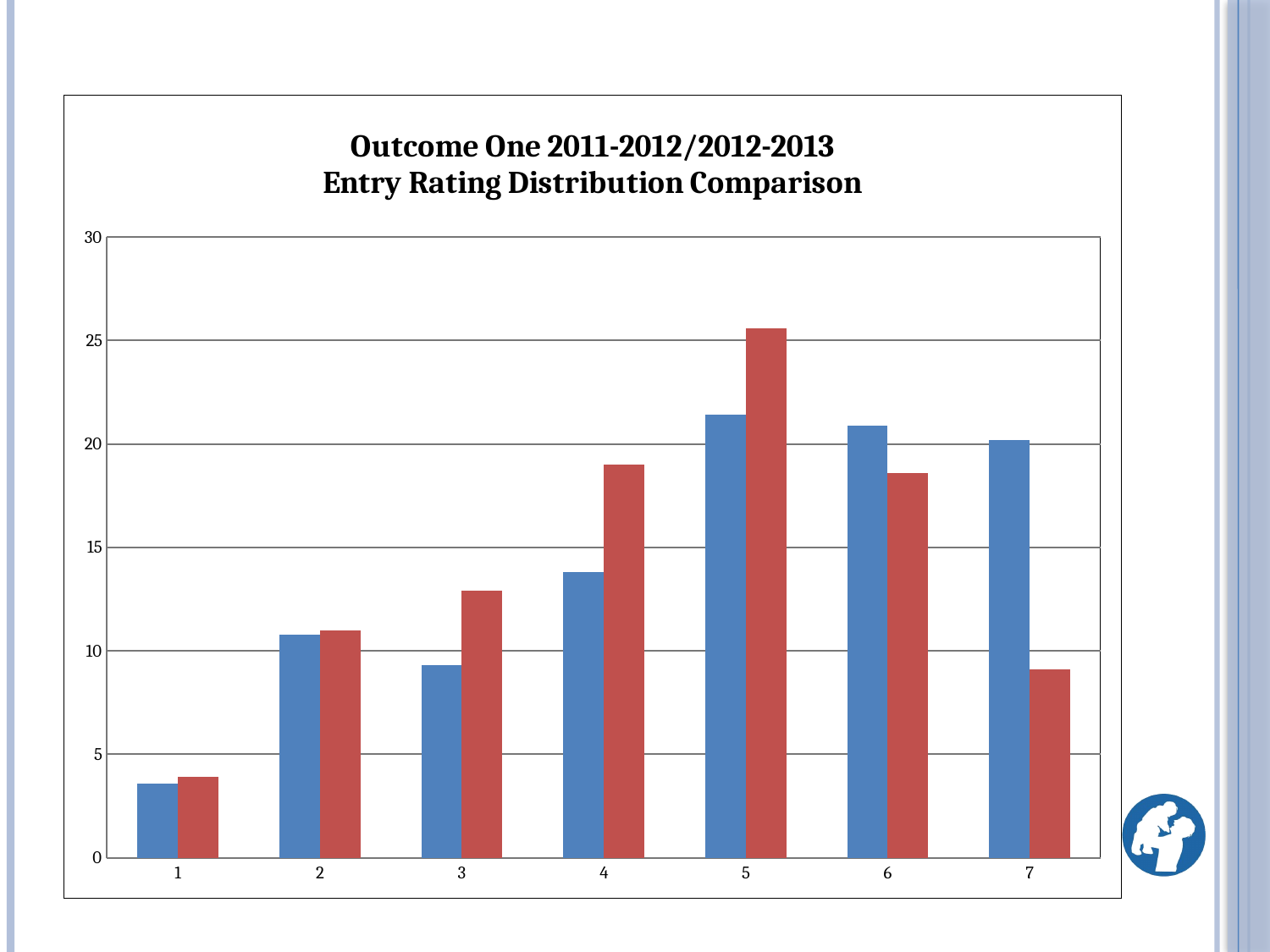
What is the title of the chart? Outcome One 2011-2012/2012-2013 Entry Rating Distribution Comparison For category 7, which bar is larger, the blue bar or the red bar? the blue bar For which category is the blue bar lowest? 1 Is the value of the blue bar for category 5 greater or less than 20? greater For which category is the red bar highest? 5 Is the value of the red bar for category 7 greater or less than 10? less Is the value of the red bar for category 5 greater or less than 25? greater How many bars are plotted for each category on the x axis? 2 How many categories are shown on the x axis? 7 For category 4, which bar is larger, the blue bar or the red bar? the red bar What kind of chart is shown on the slide? bar chart For which category is the red bar lowest? 1